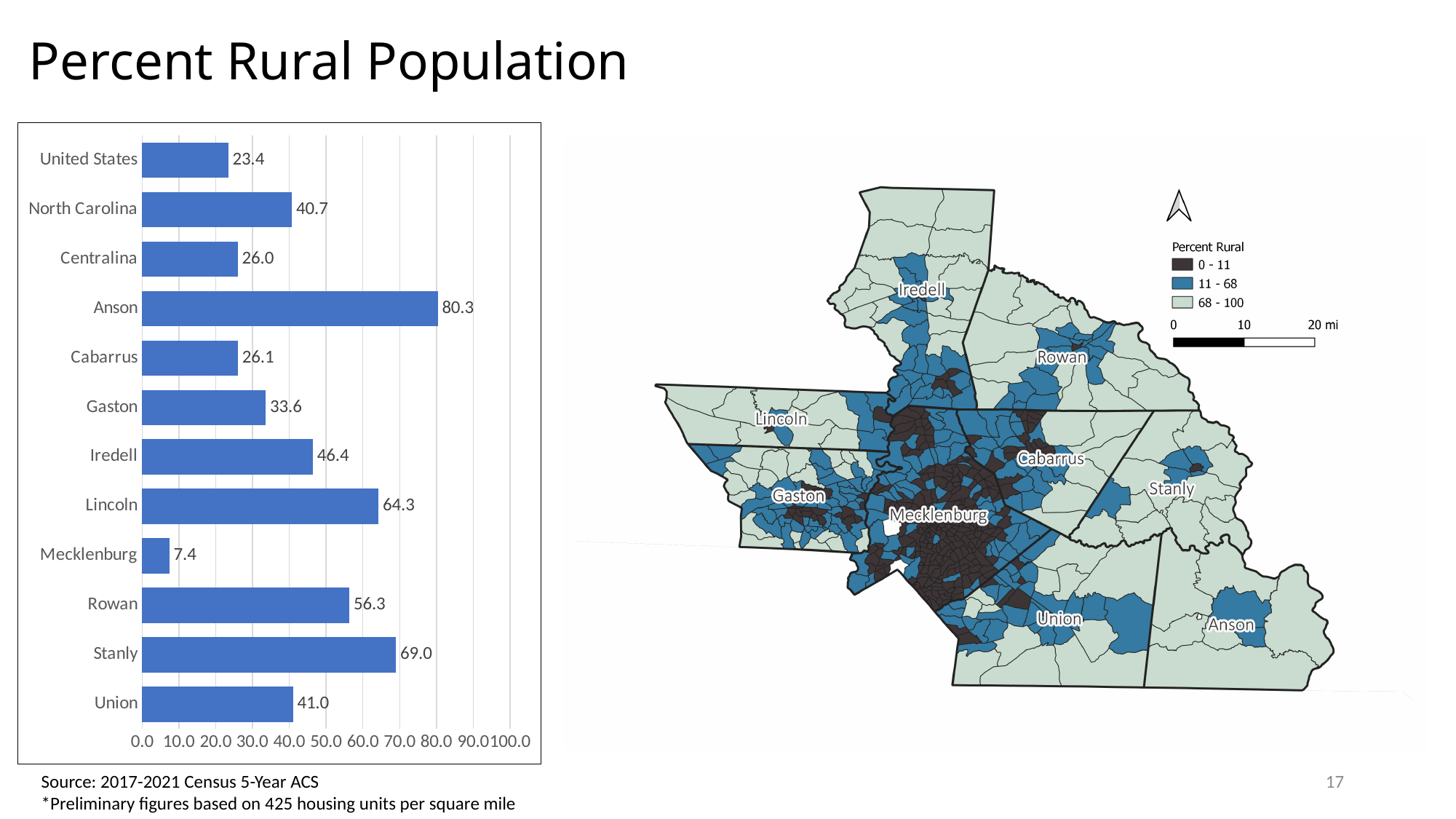
Is the value for Iredell in the bar chart greater or less than 40.0? greater How many categories are shown in the bar chart? 12 What is the difference between the values for Cabarrus and Centralina in the bar chart? 0.1 What is the percent rural population value shown for Anson in the bar chart? 80.3 What is the value shown for Mecklenburg in the bar chart? 7.4 What is the difference between the values for Stanly and Union in the bar chart? 28.0 What is the title of the slide containing the bar chart? Percent Rural Population What kind of chart is shown on the left of the slide? bar chart Which category has the highest value in the bar chart? Anson Which category has the lowest value in the bar chart? Mecklenburg Which has a larger value in the bar chart, Lincoln or Rowan? Lincoln What is the value shown for North Carolina in the bar chart? 40.7